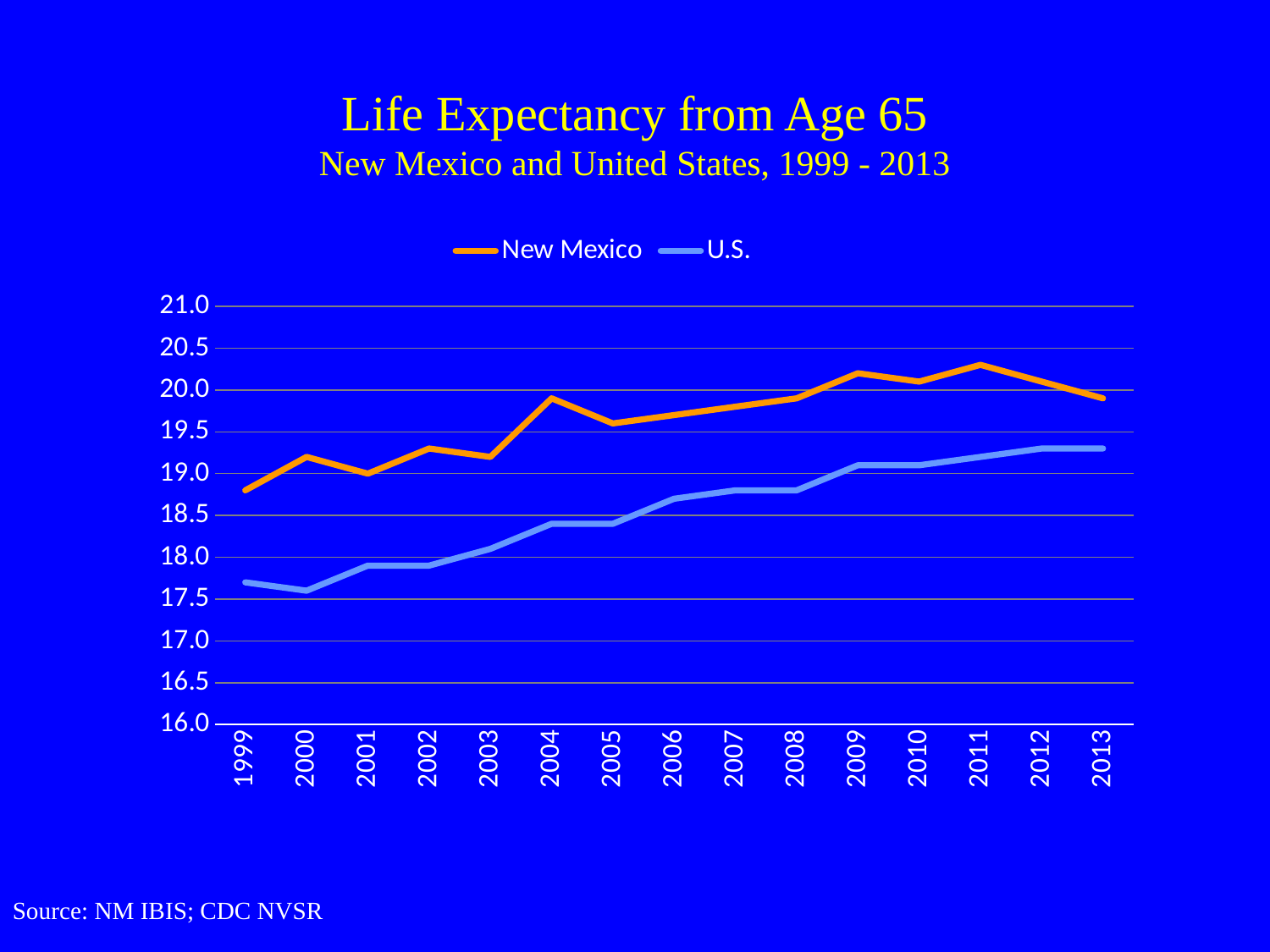
Which colour is used for the New Mexico line? Orange Is the value for New Mexico in 2004 greater or less than 19.5? greater Does the U.S. line generally rise or fall from 1999 to 2013? Rise What is the title of the chart? Life Expectancy from Age 65 Is the value for New Mexico in 2011 greater or less than 20.0? greater How many series does the legend list? 2 Is the value for U.S. in 1999 greater or less than 18.0? less Which series has the higher value in 2008, New Mexico or U.S.? New Mexico What kind of chart is shown on the slide? Line chart How many years are plotted along the x axis? 15